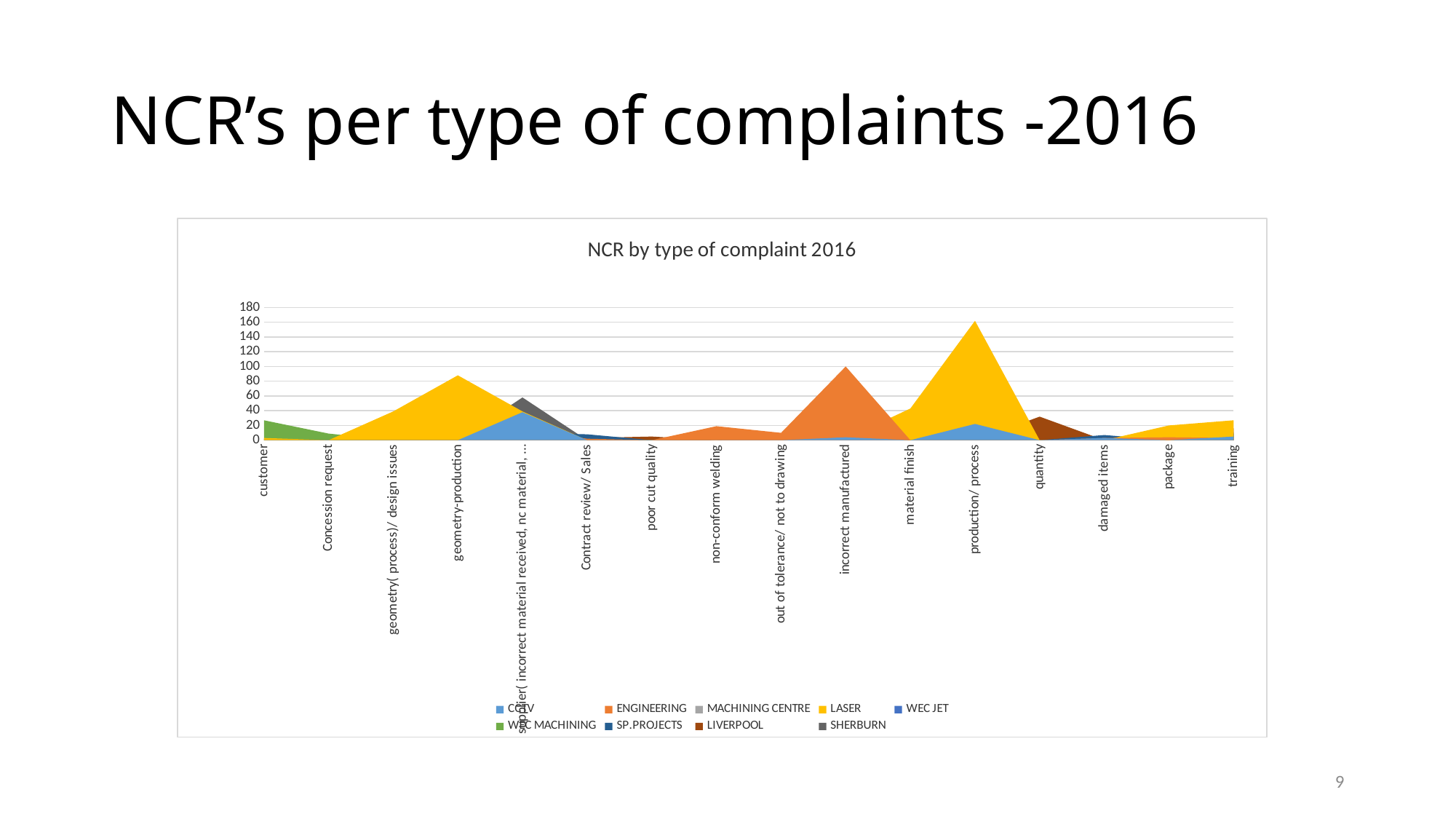
Which complaint type has the highest total value? production/ process Which has a larger total value, production/ process or incorrect manufactured? production/ process Is the total value for customer greater or less than 40? less Is the total value for production/ process greater or less than 140? greater Which series accounts for most of the value at incorrect manufactured? ENGINEERING Is the total value for geometry-production greater or less than 60? greater Which has a larger total value, geometry-production or Concession request? geometry-production What is the title of the chart? NCR by type of complaint 2016 How many complaint types are shown along the x axis? 16 How many series does the legend list? 9 What kind of chart is shown on the slide? Area chart